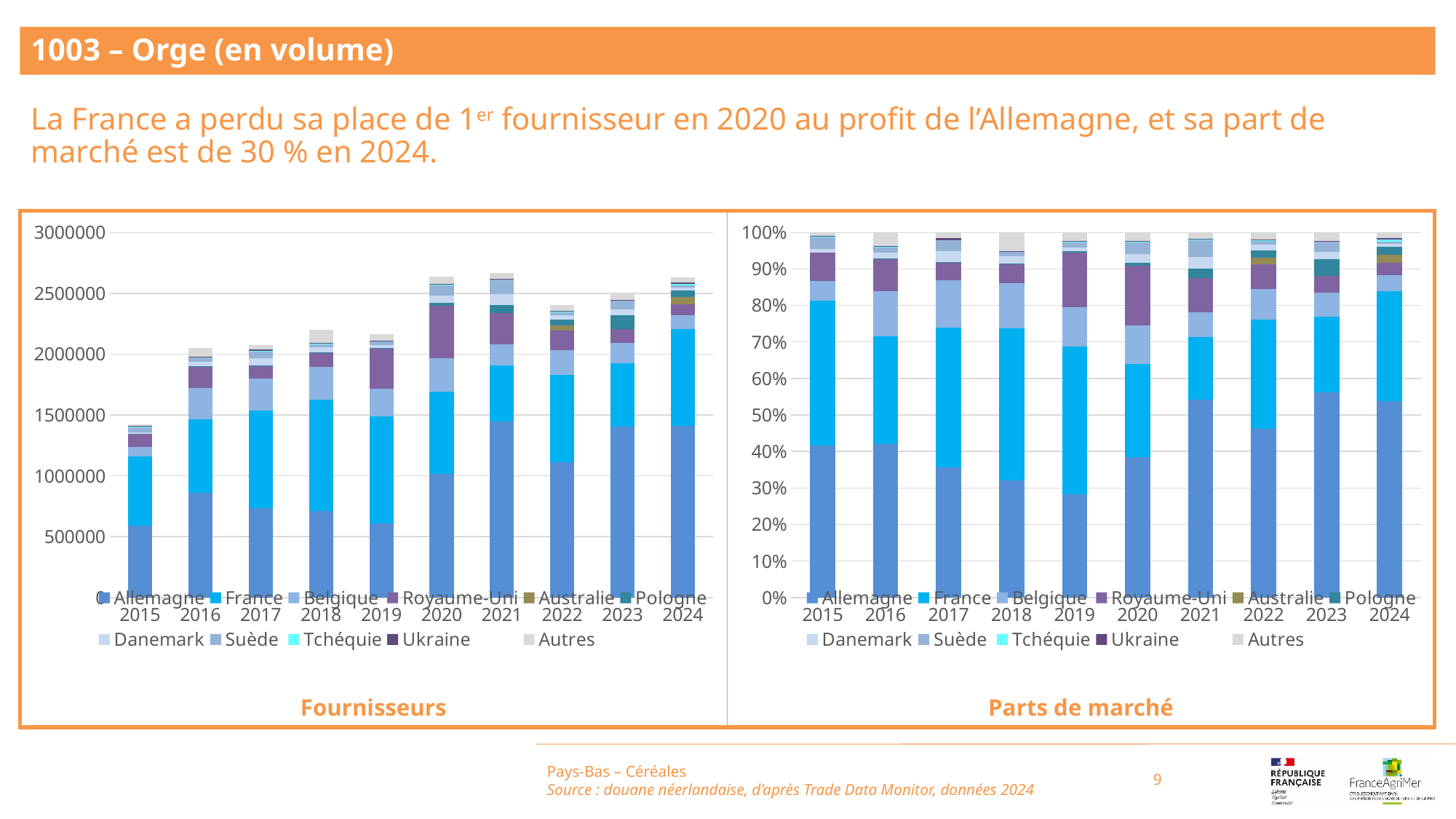
In the 'Fournisseurs' chart, is the total stacked value for 2021 greater or less than 2500000? greater In the 'Fournisseurs' chart, is the total stacked value larger in 2015 or in 2024? 2024 In the 'Fournisseurs' chart, is the total stacked value for 2019 greater or less than 2000000? greater How many series does the legend of the 'Fournisseurs' chart list? 11 In the 'Parts de marché' chart, is the share for Allemagne in 2019 greater or less than 30%? less In the 'Parts de marché' chart, does the share for Allemagne rise or fall from 2019 to 2023? rise In the 'Parts de marché' chart, which year has the lowest share for Allemagne? 2019 How many years are shown on the x axis of the 'Parts de marché' chart? 10 In the 'Fournisseurs' chart, which year has the lowest total stacked value? 2015 What kind of chart is the 'Fournisseurs' chart on the left? Stacked bar chart